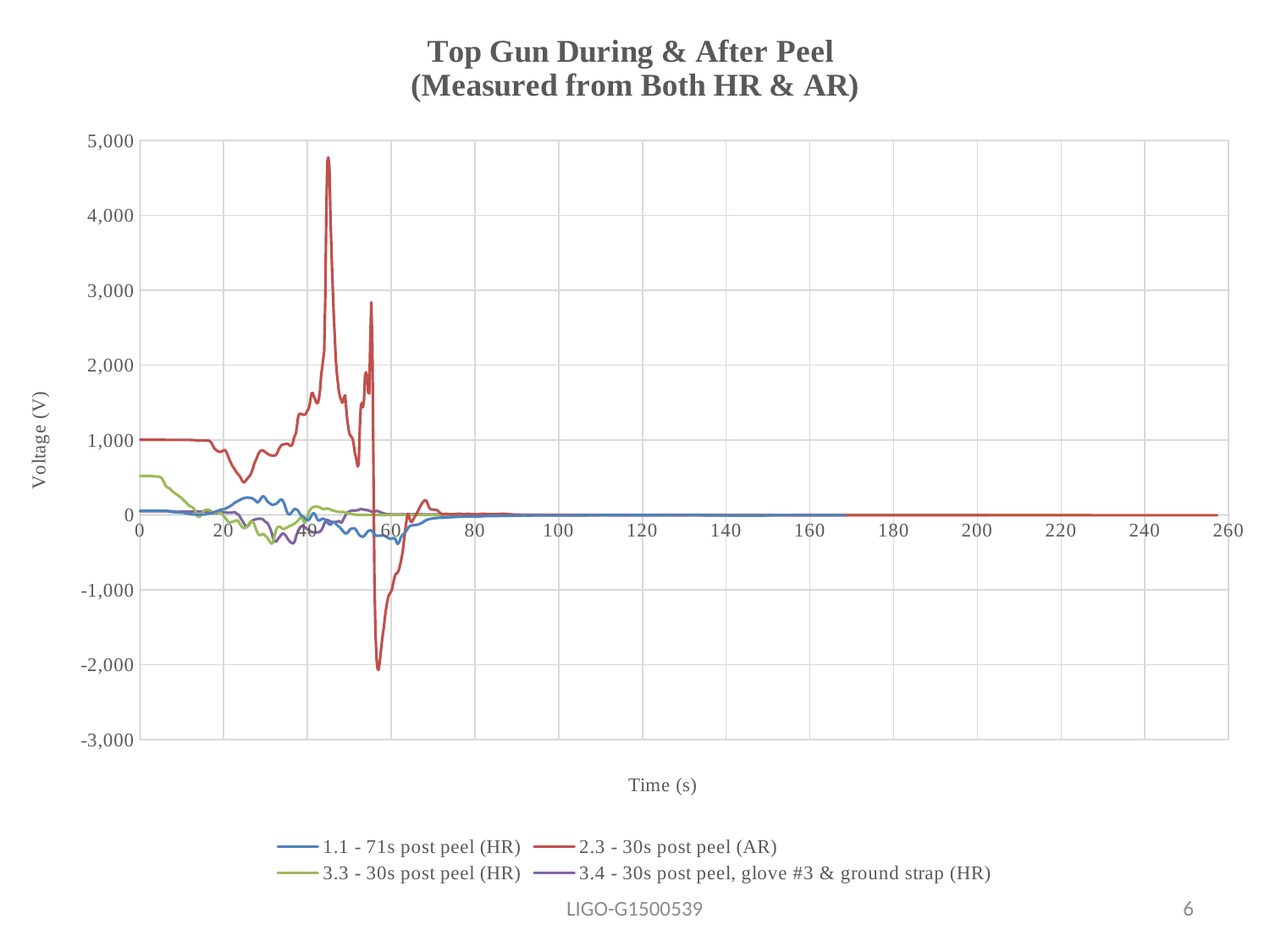
Is the value of the 3.3 - 30s post peel (HR) series at time 0 greater or less than 1,000? less Between 30 s and 45 s, does the 2.3 - 30s post peel (AR) series rise or fall overall? rise How many series does the legend list? 4 Which series reaches the highest peak voltage? 2.3 - 30s post peel (AR) What is the title of the chart? Top Gun During & After Peel (Measured from Both HR & AR) Is the minimum value of the 2.3 - 30s post peel (AR) series greater or less than -1,000? less At time 0, which series has the higher voltage: 2.3 - 30s post peel (AR) or 3.3 - 30s post peel (HR)? 2.3 - 30s post peel (AR) What kind of chart is shown on the slide? line chart What is the label of the vertical axis? Voltage (V) Is the value of the 2.3 - 30s post peel (AR) series at time 0 greater or less than 500? greater Which series reaches the lowest (most negative) voltage? 2.3 - 30s post peel (AR)